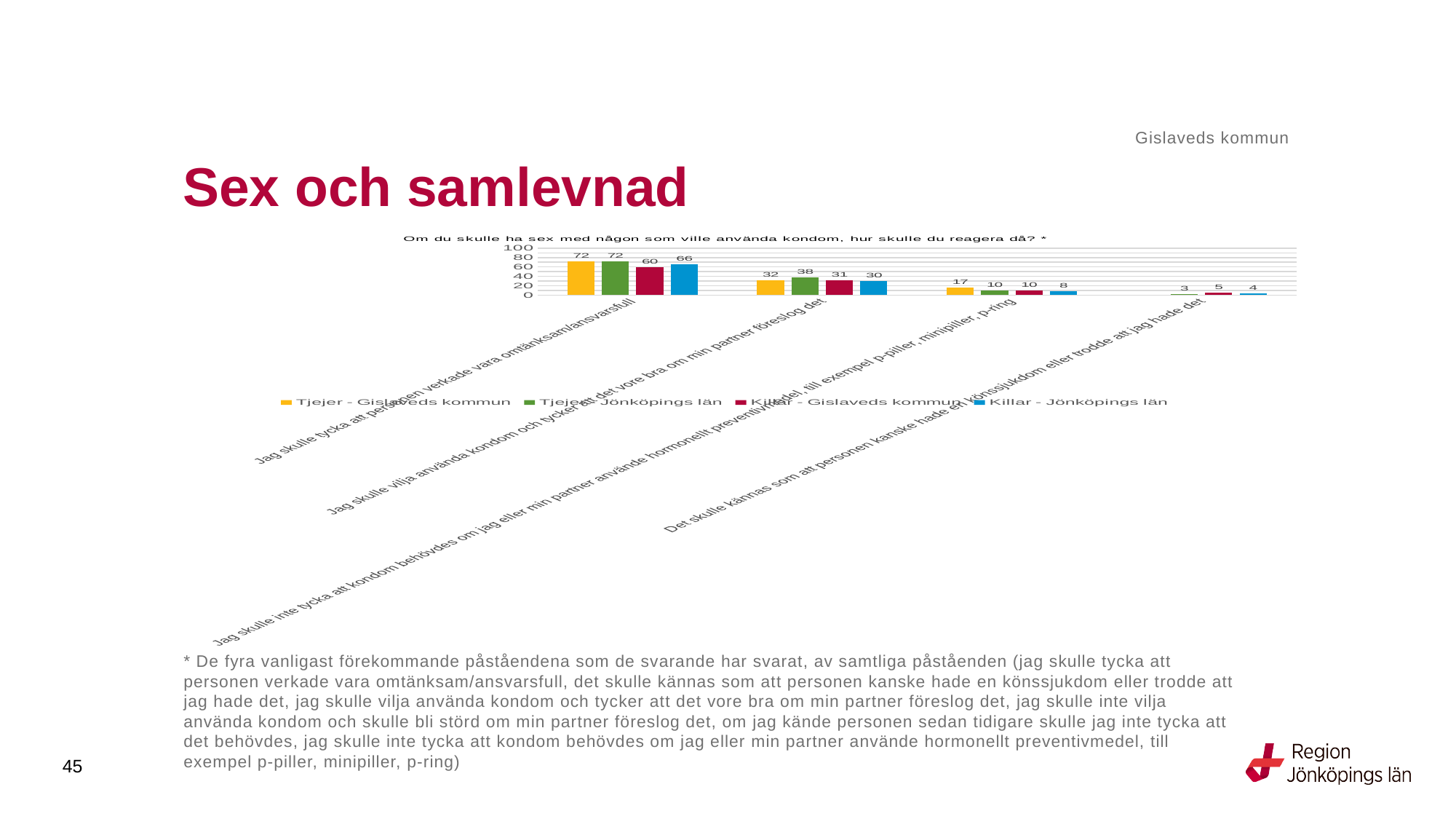
What is the value for Killar - Gislaveds kommun for 'Det skulle kännas som att personen kanske hade en könssjukdom eller trodde att jag hade det'? 5 What is the difference between Tjejer - Jönköpings län and Killar - Jönköpings län for 'Jag skulle vilja använda kondom och tycker att det vore bra om min partner föreslog det'? 8 What is the value for Killar - Gislaveds kommun for 'Jag skulle tycka att personen verkade vara omtänksam/ansvarsfull'? 60 Which is larger for 'Jag skulle tycka att personen verkade vara omtänksam/ansvarsfull': Killar - Gislaveds kommun or Killar - Jönköpings län? Killar - Jönköpings län What is the value for Tjejer - Gislaveds kommun for 'Jag skulle tycka att personen verkade vara omtänksam/ansvarsfull'? 72 What is the value for Killar - Jönköpings län for 'Jag skulle inte tycka att kondom behövdes om jag eller min partner använde hormonellt preventivmedel'? 8 What kind of chart is shown on the slide? bar chart Which colour represents Killar - Jönköpings län in the legend? blue How many series does the legend list? 4 Which series has the lowest value for 'Jag skulle tycka att personen verkade vara omtänksam/ansvarsfull'? Killar - Gislaveds kommun Which series has the highest value for 'Jag skulle inte tycka att kondom behövdes om jag eller min partner använde hormonellt preventivmedel'? Tjejer - Gislaveds kommun What is the value for Tjejer - Jönköpings län for 'Jag skulle vilja använda kondom och tycker att det vore bra om min partner föreslog det'? 38